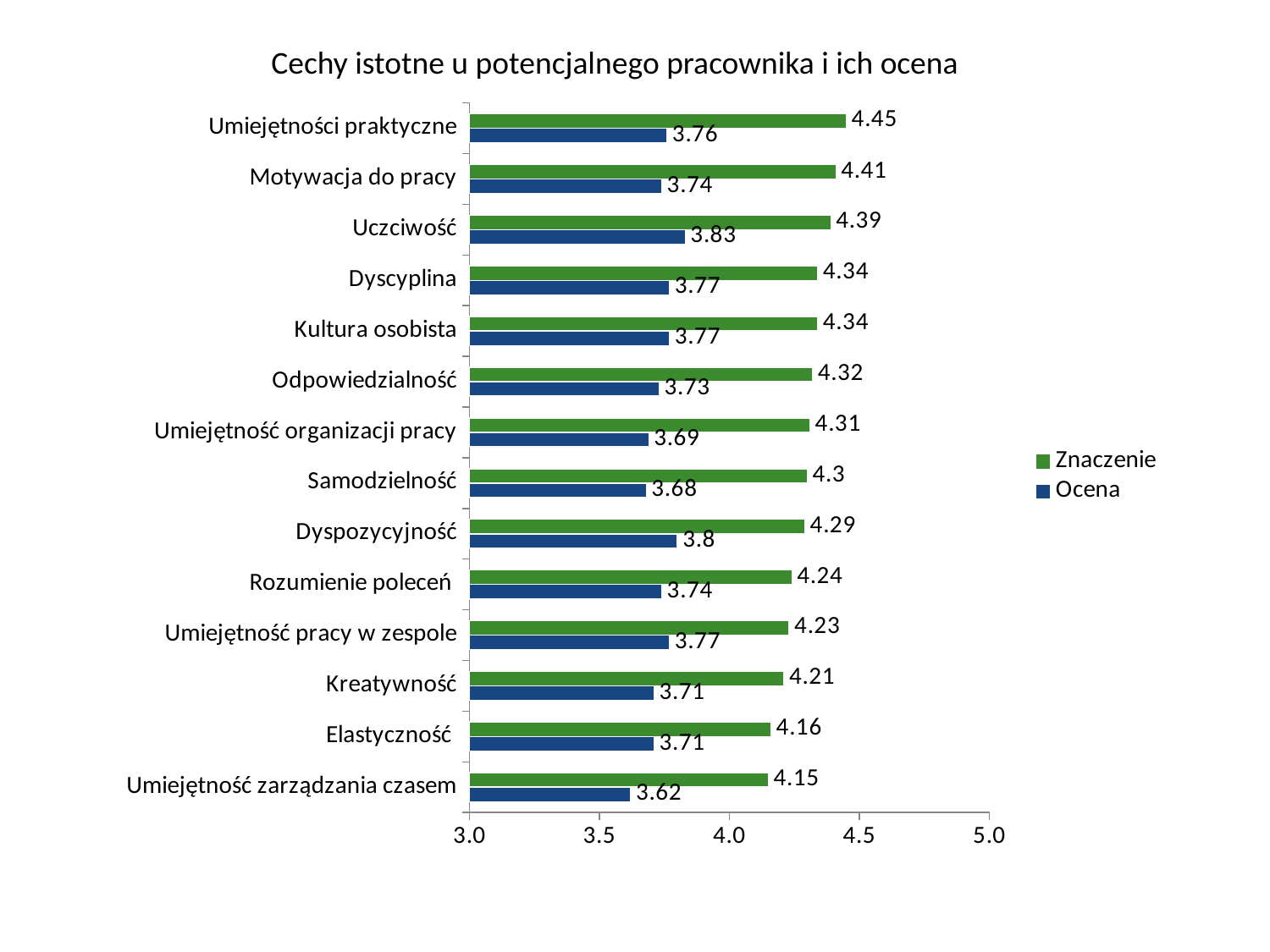
What kind of chart is shown on the slide? Bar chart How many categories are shown on the chart? 14 Which category has the lowest Ocena value? Umiejętność zarządzania czasem How many series does the legend list? 2 What is the Znaczenie value for Uczciwość? 4.39 Which category has the highest Ocena value? Uczciwość Which category has the highest Znaczenie value? Umiejętności praktyczne What is the difference between the Znaczenie and Ocena values for Umiejętności praktyczne? 0.69 What is the Ocena value for Umiejętność zarządzania czasem? 3.62 What is the title of the chart? Cechy istotne u potencjalnego pracownika i ich ocena What is the Ocena value for Dyspozycyjność? 3.8 Which is larger: the Ocena value for Uczciwość or the Ocena value for Samodzielność? Uczciwość